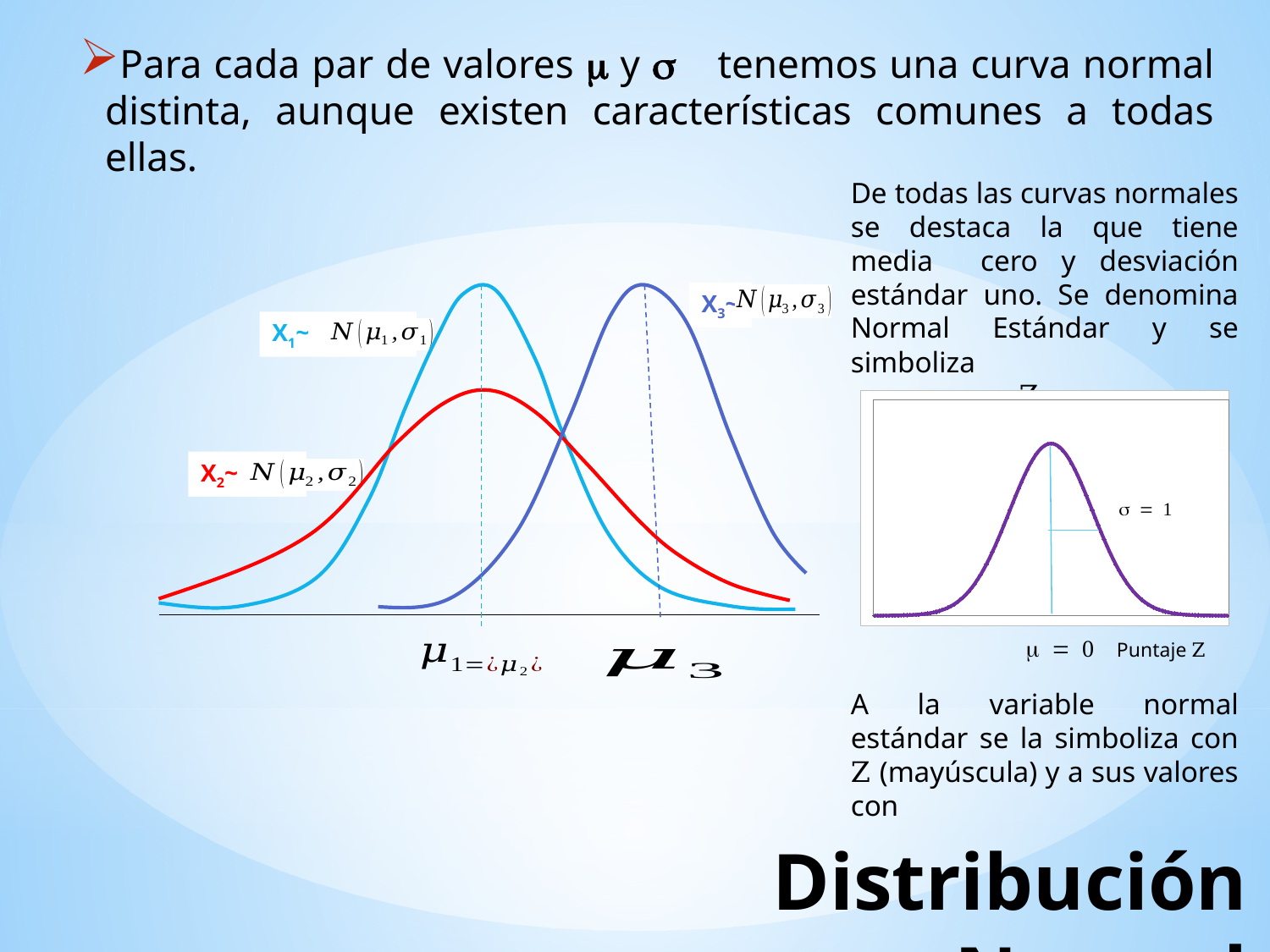
What kind of chart is the left-hand figure? line chart (normal curves) On the left-hand chart, which curve is centred furthest to the right? X3 On the left-hand chart, which curve's peak is higher, X1 or X2? X1 What is the x-axis label of the right-hand chart? Puntaje Z On the left-hand chart, which curve has the lowest peak? X2 How many normal curves are drawn on the left-hand chart? 3 How many curves are drawn on the right-hand chart? 1 On the right-hand chart of the standard normal curve, what is the value of σ? 1 On the left-hand chart, what colour is the curve labelled X2? red On the right-hand chart of the standard normal curve, what is the value of μ? 0